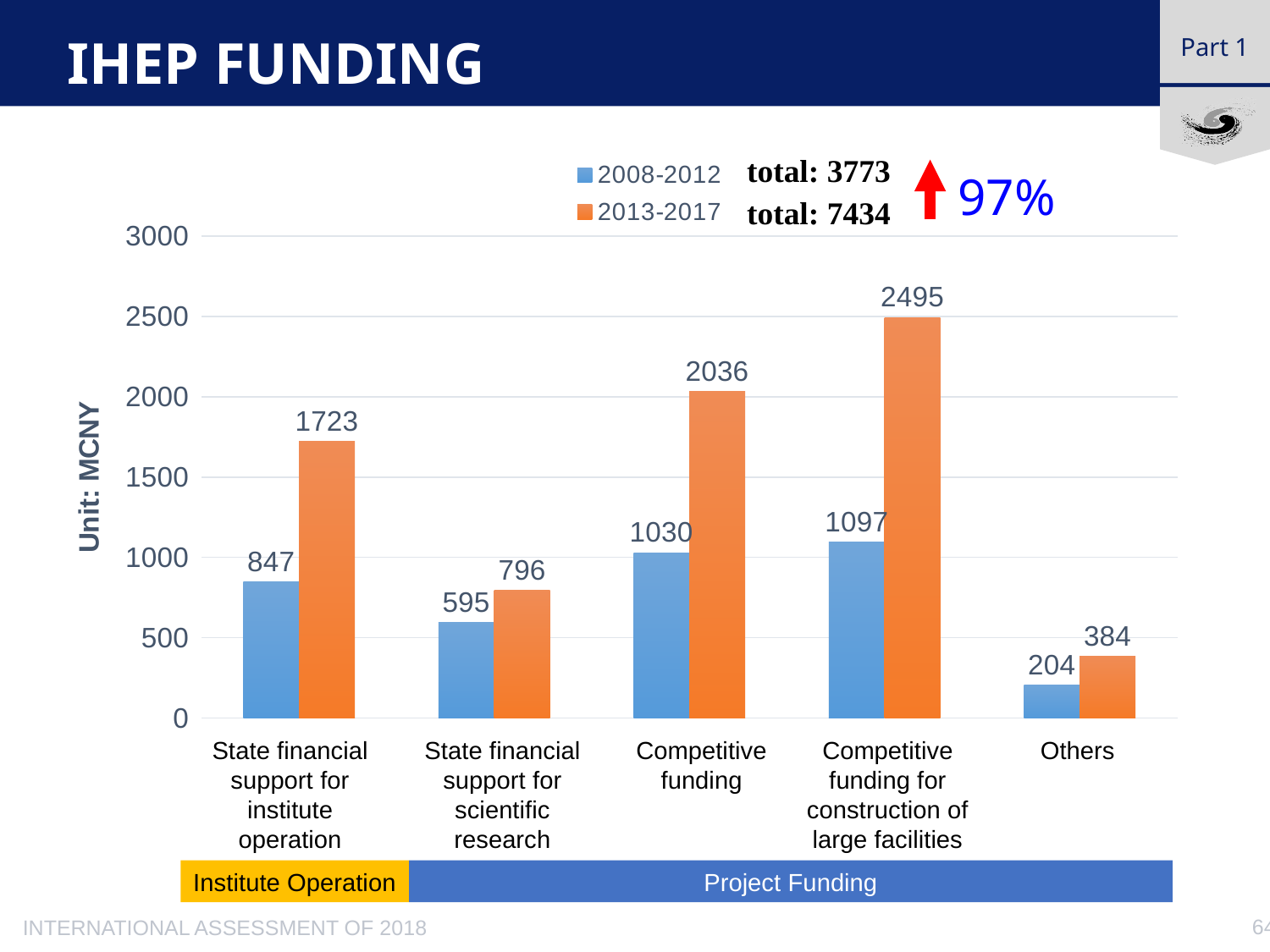
How many series does the legend list? 2 What is the 2013-2017 value for Others? 384 What is the 2008-2012 value for State financial support for institute operation? 847 What is the 2013-2017 value for Competitive funding for construction of large facilities? 2495 What kind of chart is shown on the slide? bar chart Which is larger: the 2013-2017 value for State financial support for scientific research or the 2008-2012 value for Competitive funding? 2008-2012 value for Competitive funding What unit is given on the y axis label? MCNY Which category has the highest 2008-2012 value? Competitive funding for construction of large facilities What is the difference between the 2013-2017 and 2008-2012 values for Competitive funding? 1006 How many categories are shown on the x axis? 5 What is the total for 2013-2017 shown next to the legend? 7434 Which category has the lowest 2013-2017 value? Others